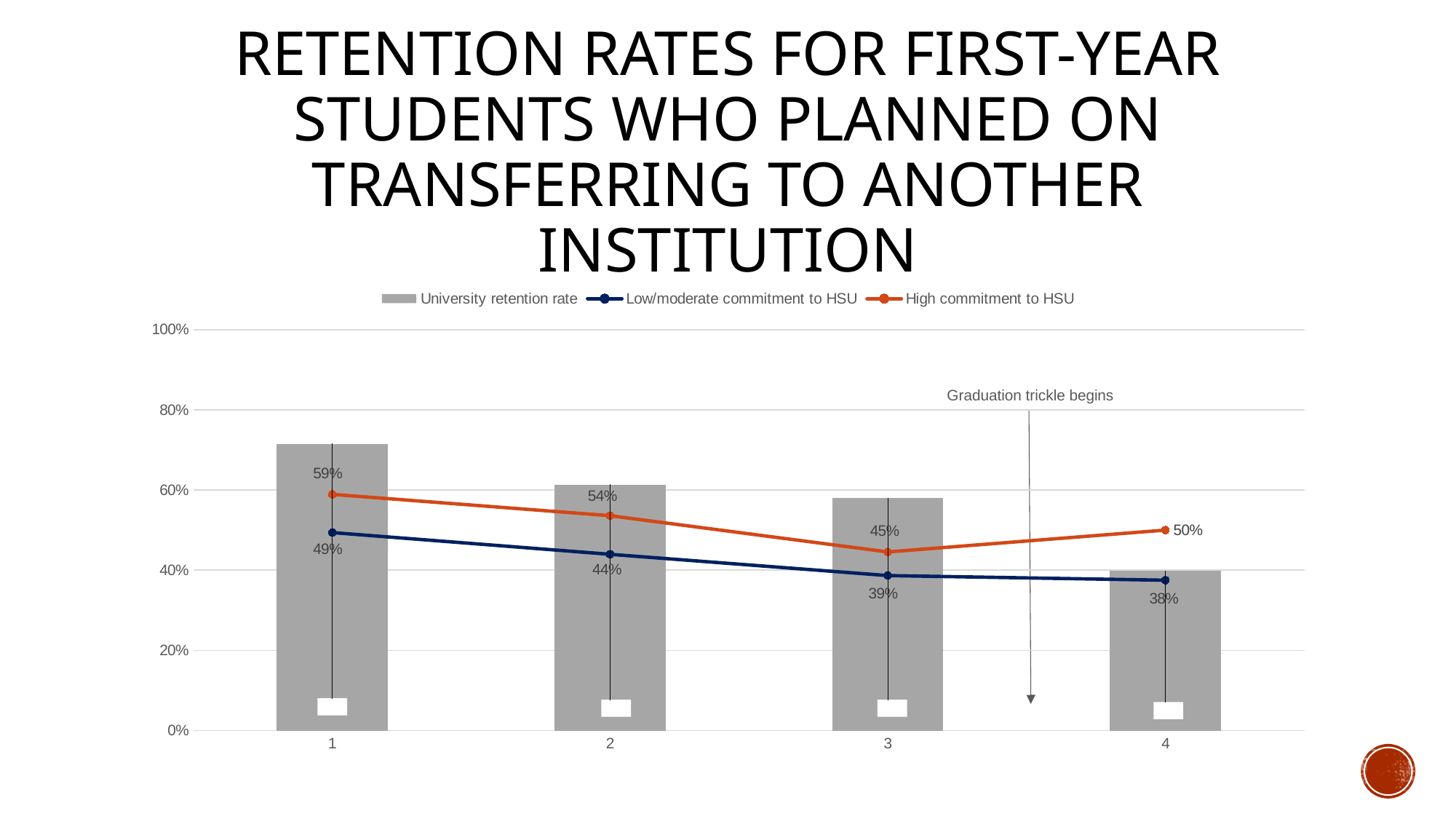
Which is larger at category 2: High commitment to HSU or Low/moderate commitment to HSU? High commitment to HSU At which category is the High commitment to HSU series lowest? 3 What is the difference between High commitment to HSU and Low/moderate commitment to HSU at category 4? 12% Does the Low/moderate commitment to HSU series rise or fall from category 1 to category 4? fall What is the value for Low/moderate commitment to HSU at category 3? 39% What is the value for High commitment to HSU at category 1? 59% What is the value for High commitment to HSU at category 4? 50% Is the University retention rate bar for category 1 greater or less than 60%? greater Is the University retention rate bar for category 4 greater or less than 60%? less How many series does the legend list? 3 At which category is the Low/moderate commitment to HSU series highest? 1 What is the value for Low/moderate commitment to HSU at category 2? 44%